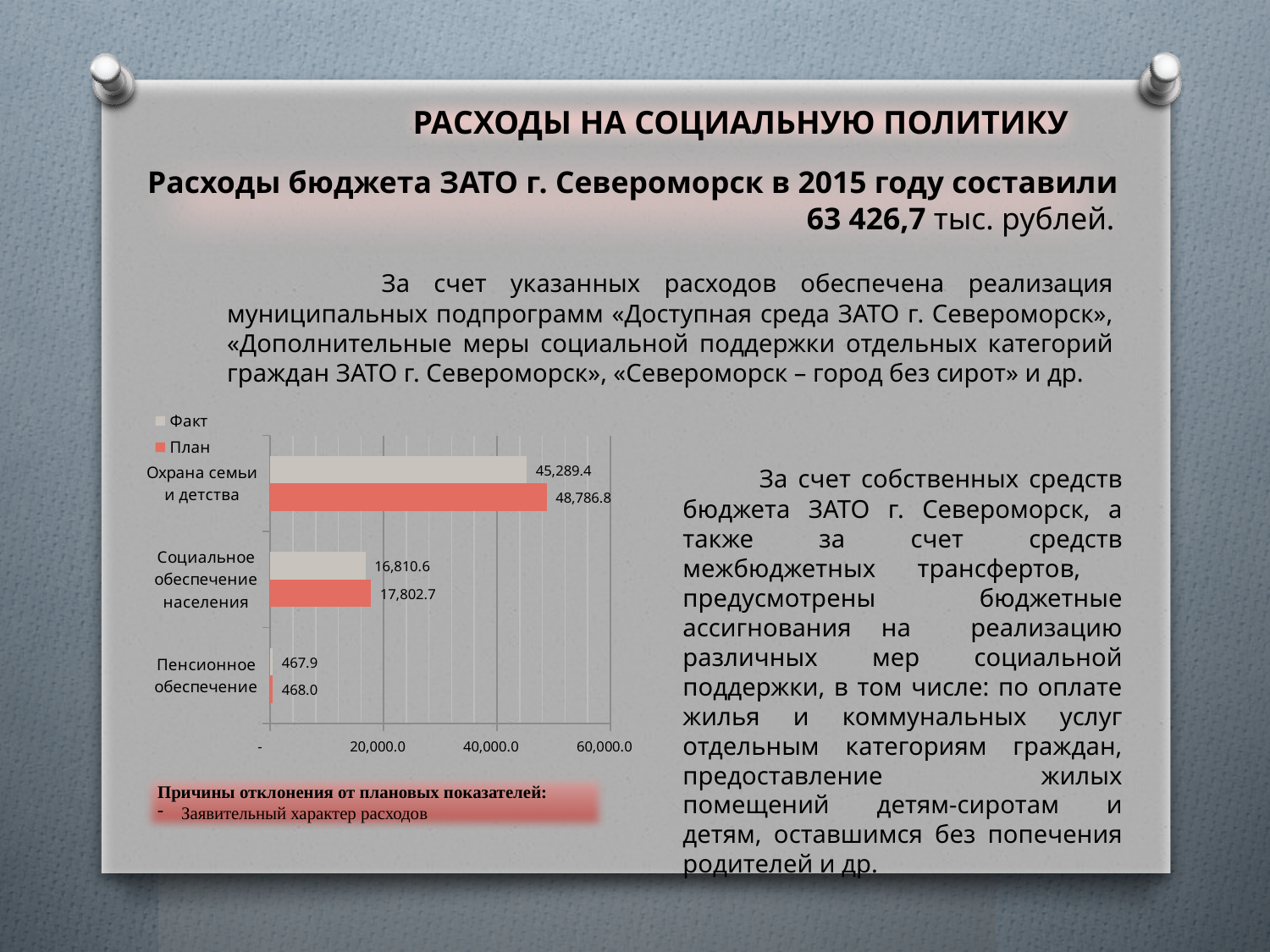
What is the Факт value for Пенсионное обеспечение? 467.9 Is the План value for Охрана семьи и детства greater or less than 40,000.0? greater What is the Факт value for Охрана семьи и детства? 45,289.4 What kind of chart is shown on the slide? bar chart What is the difference between the План and Факт values for Социальное обеспечение населения? 992.1 Which category has the highest План value? Охрана семьи и детства How many series does the legend list? 2 Which category has the lowest Факт value? Пенсионное обеспечение What is the difference between the План and Факт values for Охрана семьи и детства? 3,497.4 How many categories are shown on the chart? 3 What is the План value for Социальное обеспечение населения? 17,802.7 Which is larger for Охрана семьи и детства, the Факт value or the План value? План